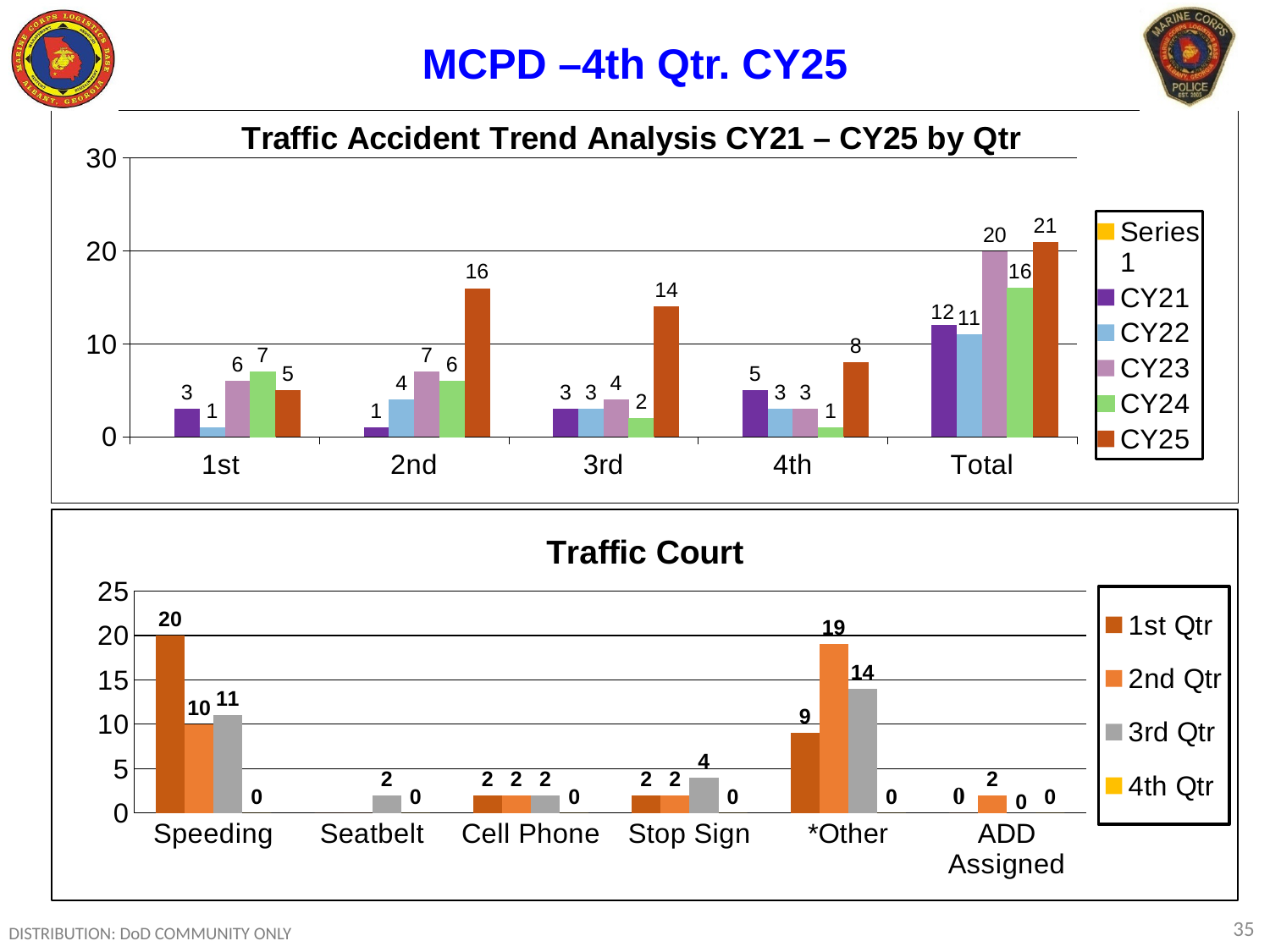
In the Traffic Accident Trend Analysis chart, what is the CY25 value for the 2nd quarter? 16 In the Traffic Accident Trend Analysis chart, what is the difference between the CY25 and CY24 values for the 3rd quarter? 12 In the Traffic Accident Trend Analysis chart, which year has the lowest Total? CY22 In the Traffic Accident Trend Analysis chart, what is the CY23 value for Total? 20 In the Traffic Court chart, what is the 2nd Qtr value for *Other? 19 In the Traffic Accident Trend Analysis chart, which year has the highest Total? CY25 In the Traffic Accident Trend Analysis chart, how many entries does the legend list? 6 In the Traffic Court chart, how many categories are shown on the x axis? 6 In the Traffic Court chart, what is the difference between the 1st Qtr and 2nd Qtr values for Speeding? 10 What kind of chart is the Traffic Court chart? Bar chart In the Traffic Court chart, which is larger for Stop Sign: the 2nd Qtr value or the 3rd Qtr value? 3rd Qtr In the Traffic Court chart, what is the 1st Qtr value for Speeding? 20